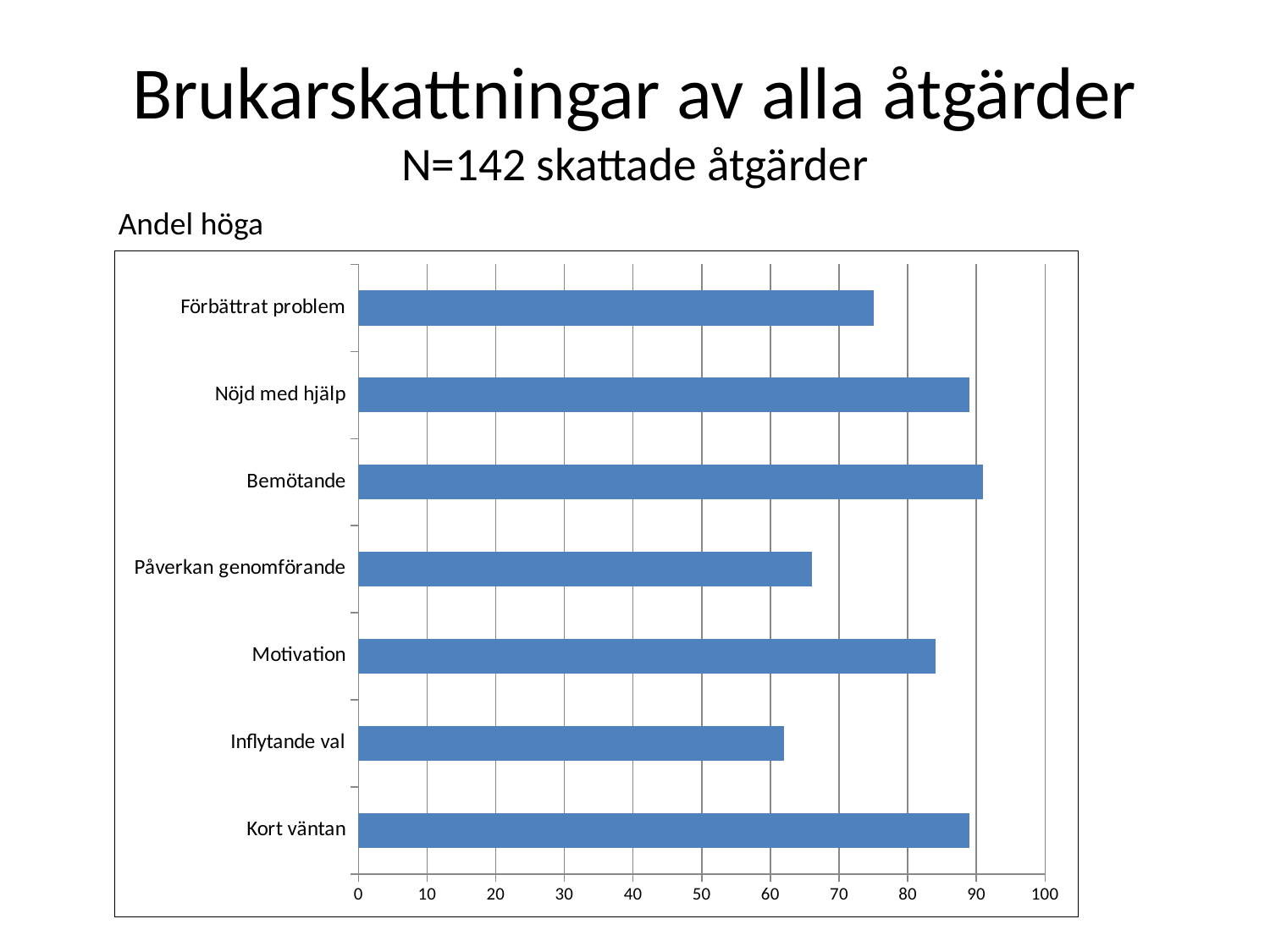
Is the value for Förbättrat problem greater or less than 70? greater Is the value for Motivation greater or less than 80? greater What is the label shown above the chart? Andel höga What kind of chart is shown on the slide? bar chart Which category has the highest value in the chart? Bemötande Is the value for Påverkan genomförande greater or less than 70? less Which is larger, the value for Förbättrat problem or the value for Inflytande val? Förbättrat problem How many categories are plotted in the chart? 7 Which category has the lowest value in the chart? Inflytande val Which is larger, the value for Motivation or the value for Påverkan genomförande? Motivation